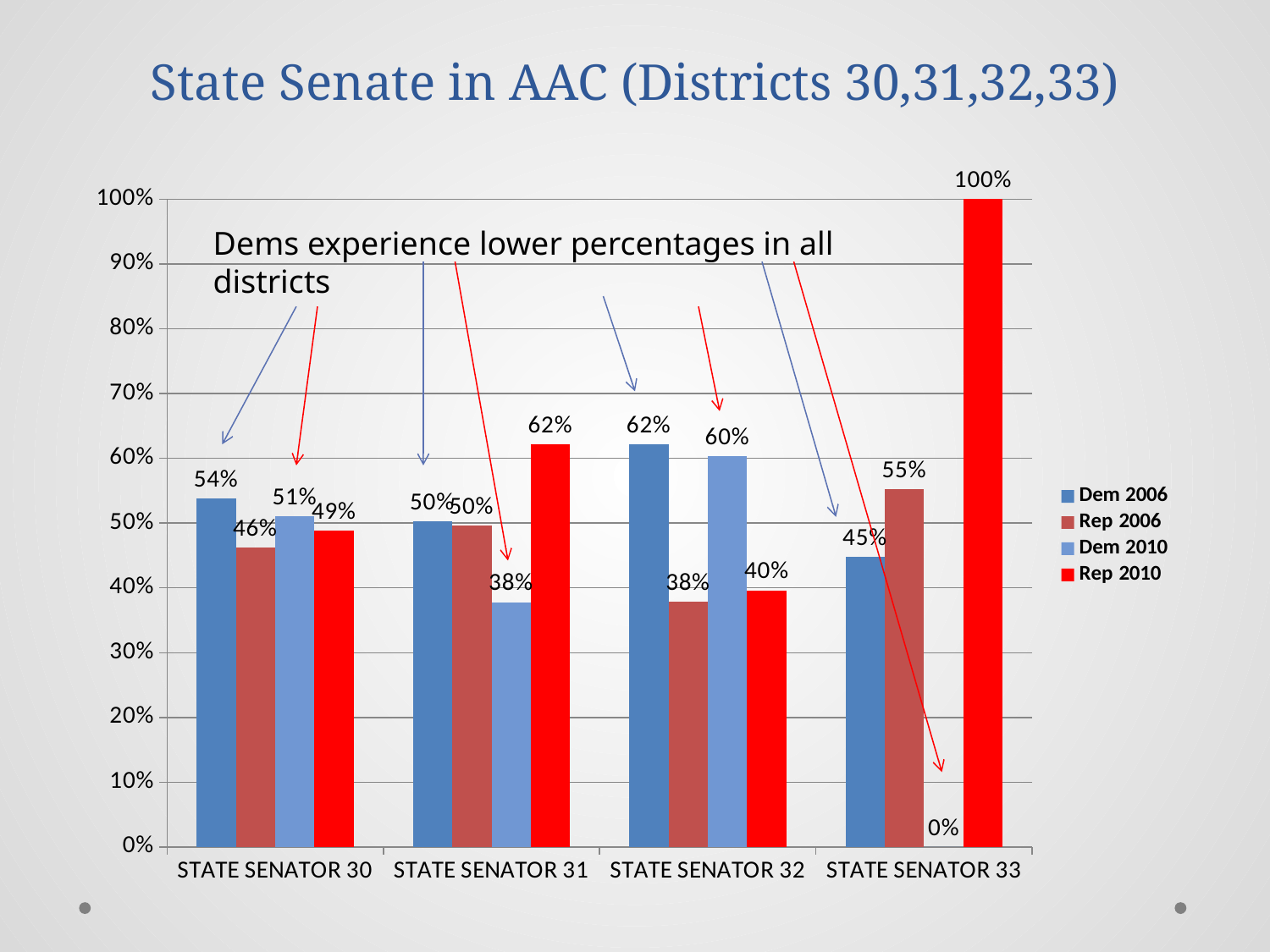
What is the Dem 2006 value for STATE SENATOR 30? 54% What is the difference between the Rep 2010 and Dem 2010 values for STATE SENATOR 31? 24% How many series does the legend list? 4 What is the Rep 2006 value for STATE SENATOR 33? 55% How many districts are shown on the x axis? 4 What is the Rep 2010 value for STATE SENATOR 33? 100% Which is larger for STATE SENATOR 32: the Rep 2006 value or the Dem 2010 value? Dem 2010 What is the Dem 2010 value for STATE SENATOR 31? 38% What is the title of the slide? State Senate in AAC (Districts 30,31,32,33) Which district has the lowest Dem 2010 value? STATE SENATOR 33 What kind of chart is shown on the slide? Bar chart Which district has the highest Dem 2006 value? STATE SENATOR 32